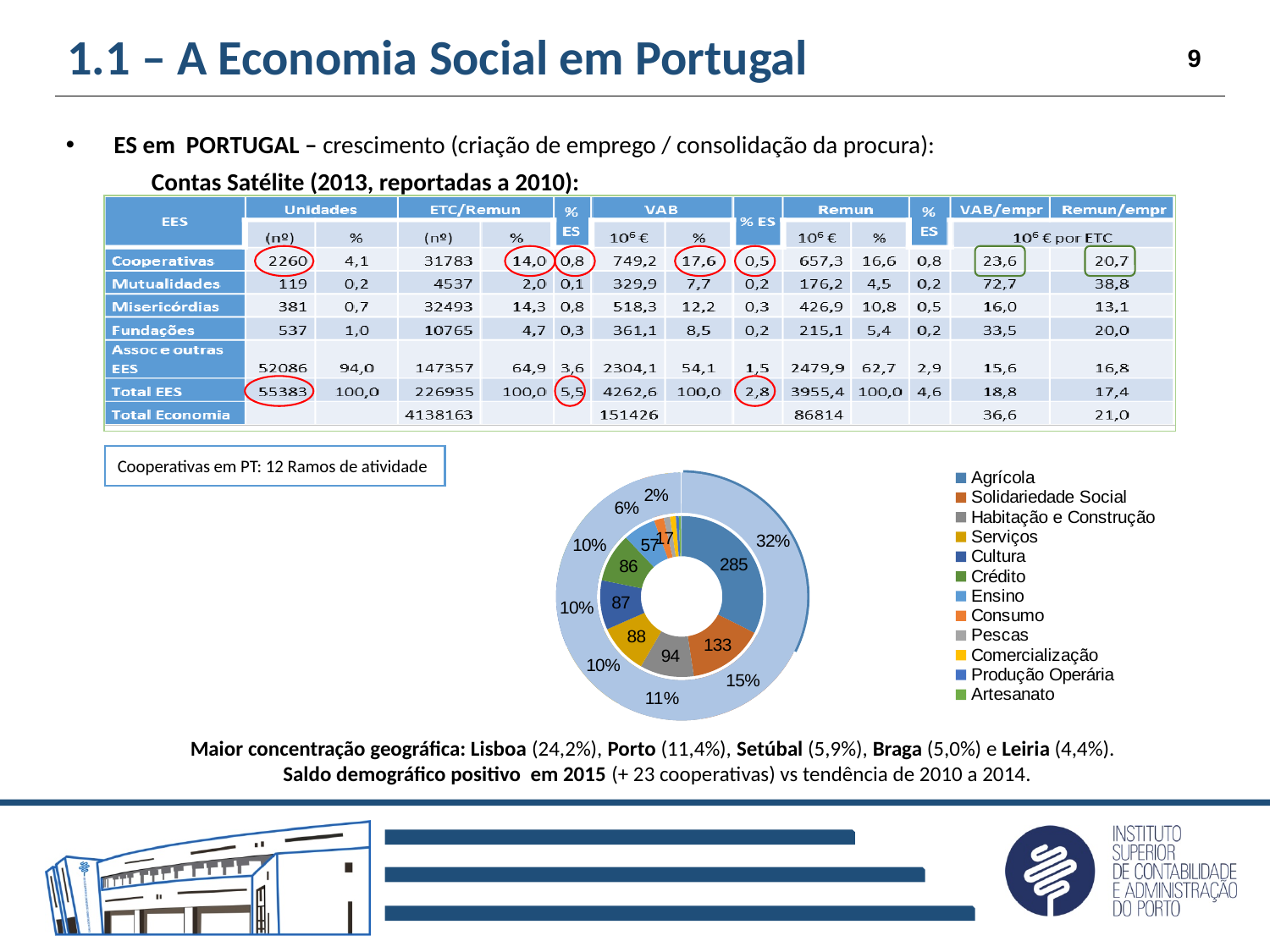
What percentage share does Habitação e Construção have in the doughnut chart? 11% How many entries does the legend of the doughnut chart list? 12 What percentage share does Solidariedade Social have in the doughnut chart? 15% According to the text box next to the chart, how many branches of activity (ramos de atividade) do cooperatives in Portugal have? 12 What is the value shown for Agrícola in the inner ring of the doughnut chart? 285 What percentage share does Agrícola have in the doughnut chart? 32% What is the value shown for Ensino in the inner ring of the doughnut chart? 57 What is the difference between the values for Agrícola and Solidariedade Social in the doughnut chart? 152 What kind of chart is shown on the slide? Doughnut (pie) chart What is the value shown for Solidariedade Social in the inner ring of the doughnut chart? 133 Which is larger in the doughnut chart, Agrícola or Habitação e Construção? Agrícola Which category has the largest slice in the doughnut chart? Agrícola